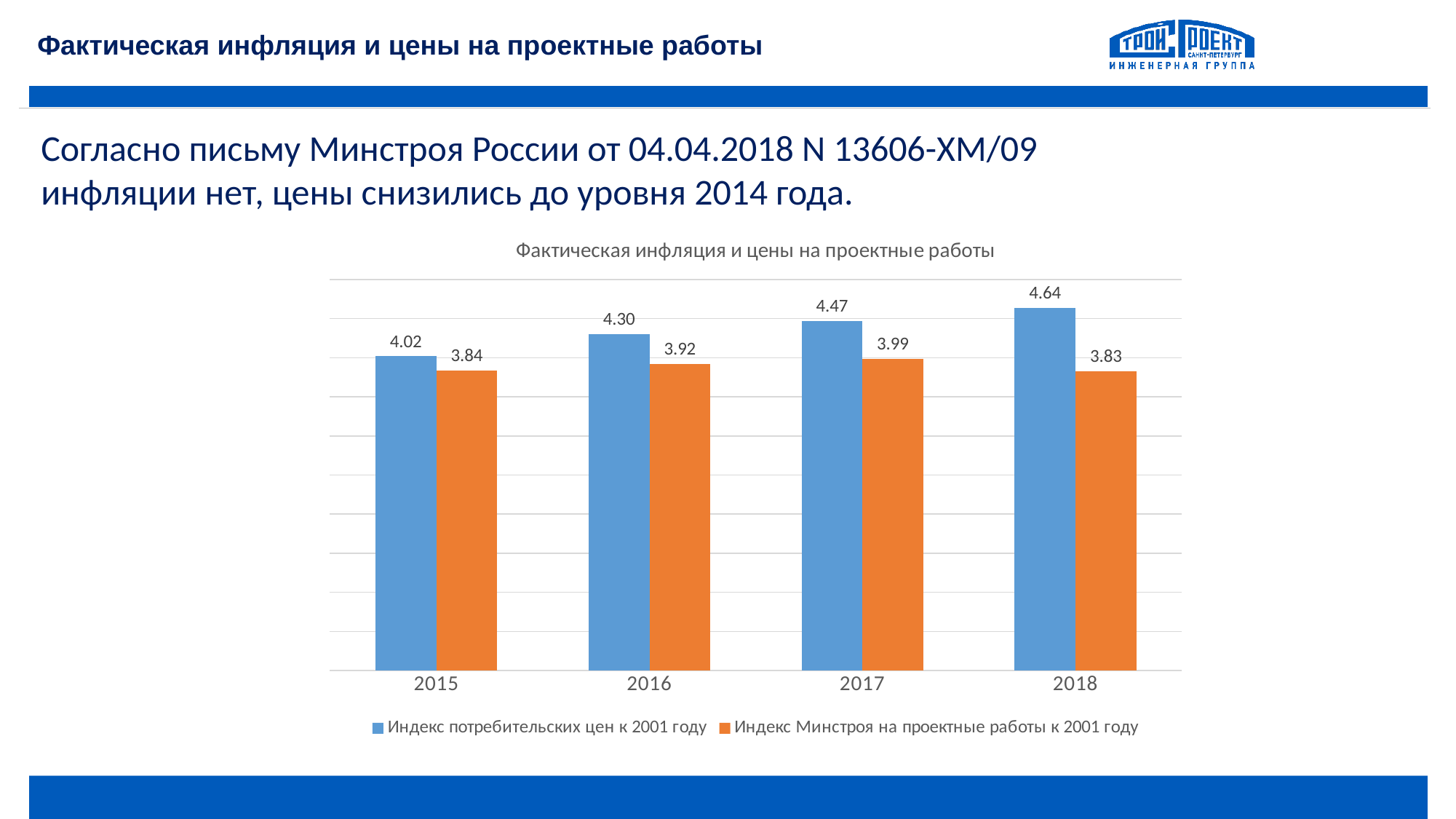
How many series does the legend list? 2 In which year is Индекс Минстроя на проектные работы к 2001 году highest? 2017 What is the title of the chart? Фактическая инфляция и цены на проектные работы How many years are shown on the x axis? 4 Which is larger in 2017: Индекс потребительских цен к 2001 году or Индекс Минстроя на проектные работы к 2001 году? Индекс потребительских цен к 2001 году What is the difference between Индекс потребительских цен к 2001 году and Индекс Минстроя на проектные работы к 2001 году in 2018? 0.81 What is the value of Индекс потребительских цен к 2001 году for 2015? 4.02 What is the value of Индекс Минстроя на проектные работы к 2001 году for 2016? 3.92 What kind of chart is shown? Bar chart What is the value of Индекс потребительских цен к 2001 году for 2018? 4.64 Does Индекс потребительских цен к 2001 году rise or fall from 2015 to 2018? Rise In which year is Индекс Минстроя на проектные работы к 2001 году lowest? 2018